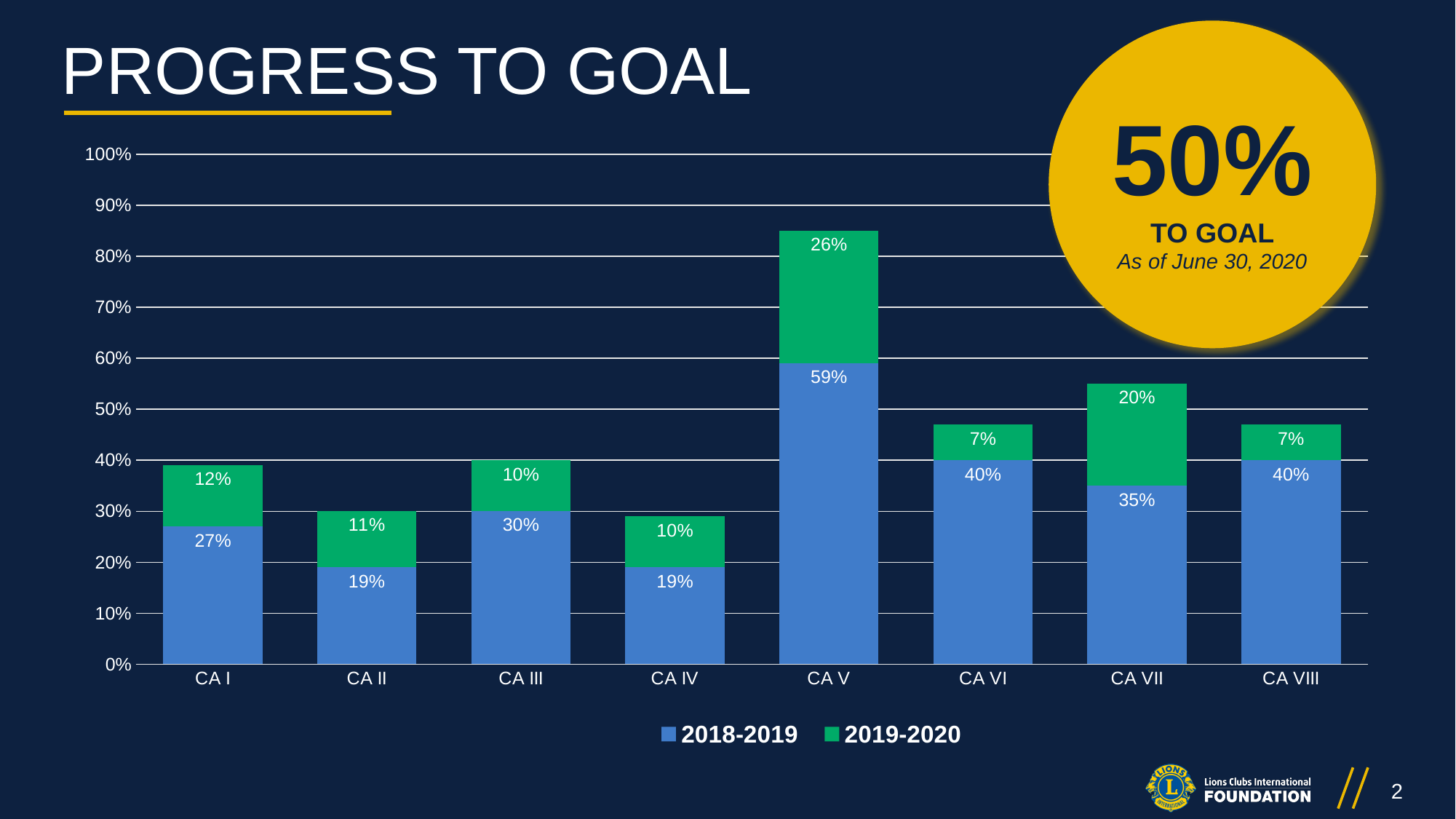
Which category has the lowest 2018-2019 value, CA II or CA IV, or are they equal? They are equal (19%) What is the 2019-2020 value for CA VII? 20% Is the 2019-2020 value for CA I larger than the 2019-2020 value for CA VI? Yes What is the 2018-2019 value for CA V? 59% What type of chart is shown on the slide? Stacked bar chart How many series does the legend list? 2 What is the difference between the 2018-2019 values for CA V and CA VII? 24% What is the 2018-2019 value for CA II? 19% How many categories are shown on the x axis? 8 What is the total stacked value for CA I? 39% Which category has the highest 2019-2020 value? CA V What is the total stacked value for CA V? 85%